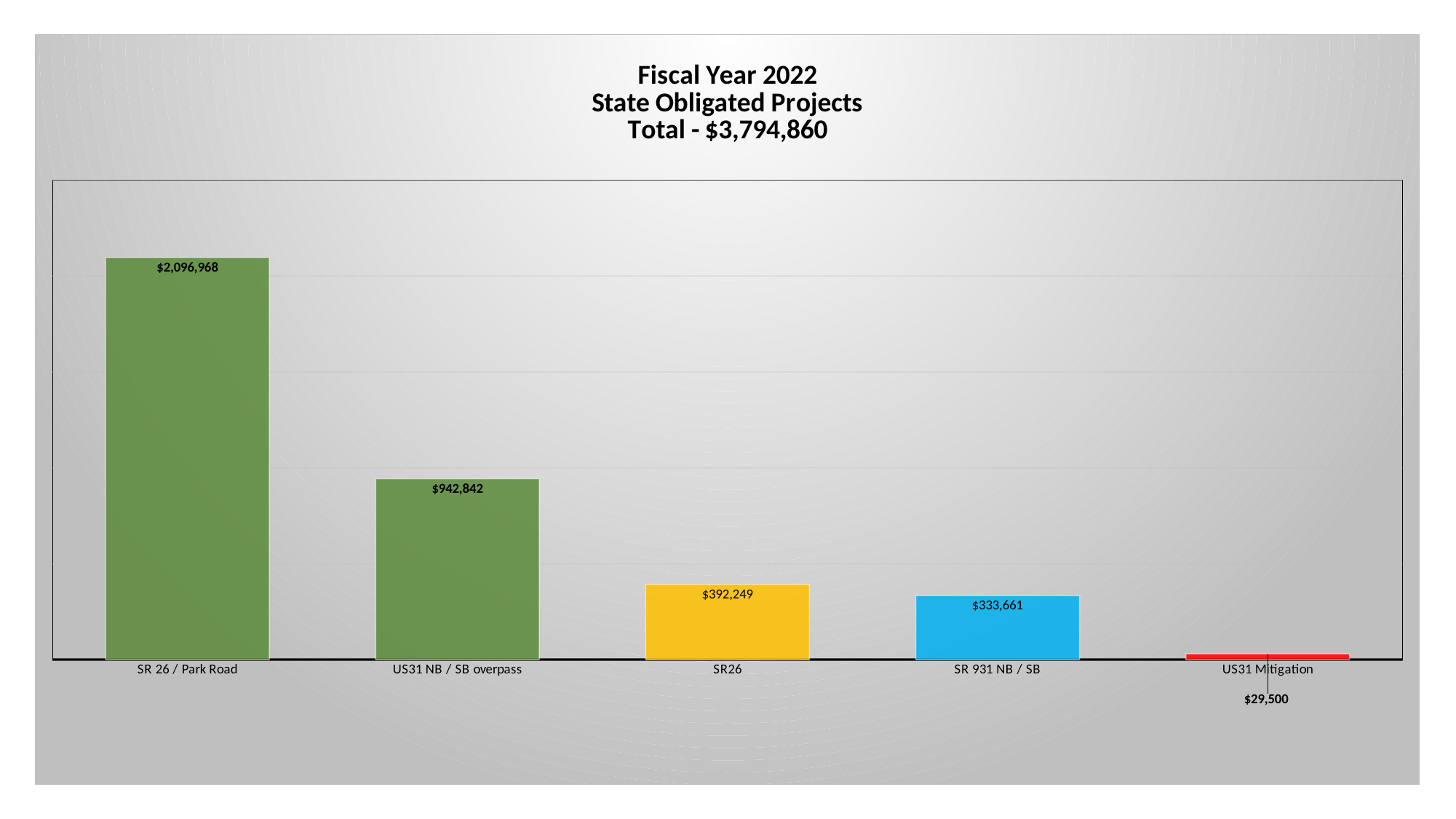
What is the difference between the values for SR26 and SR 931 NB / SB? $58,588 What kind of chart is this? Bar chart What is the value for US31 Mitigation? $29,500 What is the value for SR 931 NB / SB? $333,661 What is the difference between the values for SR 26 / Park Road and US31 NB / SB overpass? $1,154,126 What is the value for SR26? $392,249 Which category has the lowest value? US31 Mitigation Which category has the highest value? SR 26 / Park Road How many categories are shown in the chart? 5 What is the value for SR 26 / Park Road? $2,096,968 Which is larger, the value for US31 NB / SB overpass or the value for SR26? US31 NB / SB overpass What is the value for US31 NB / SB overpass? $942,842